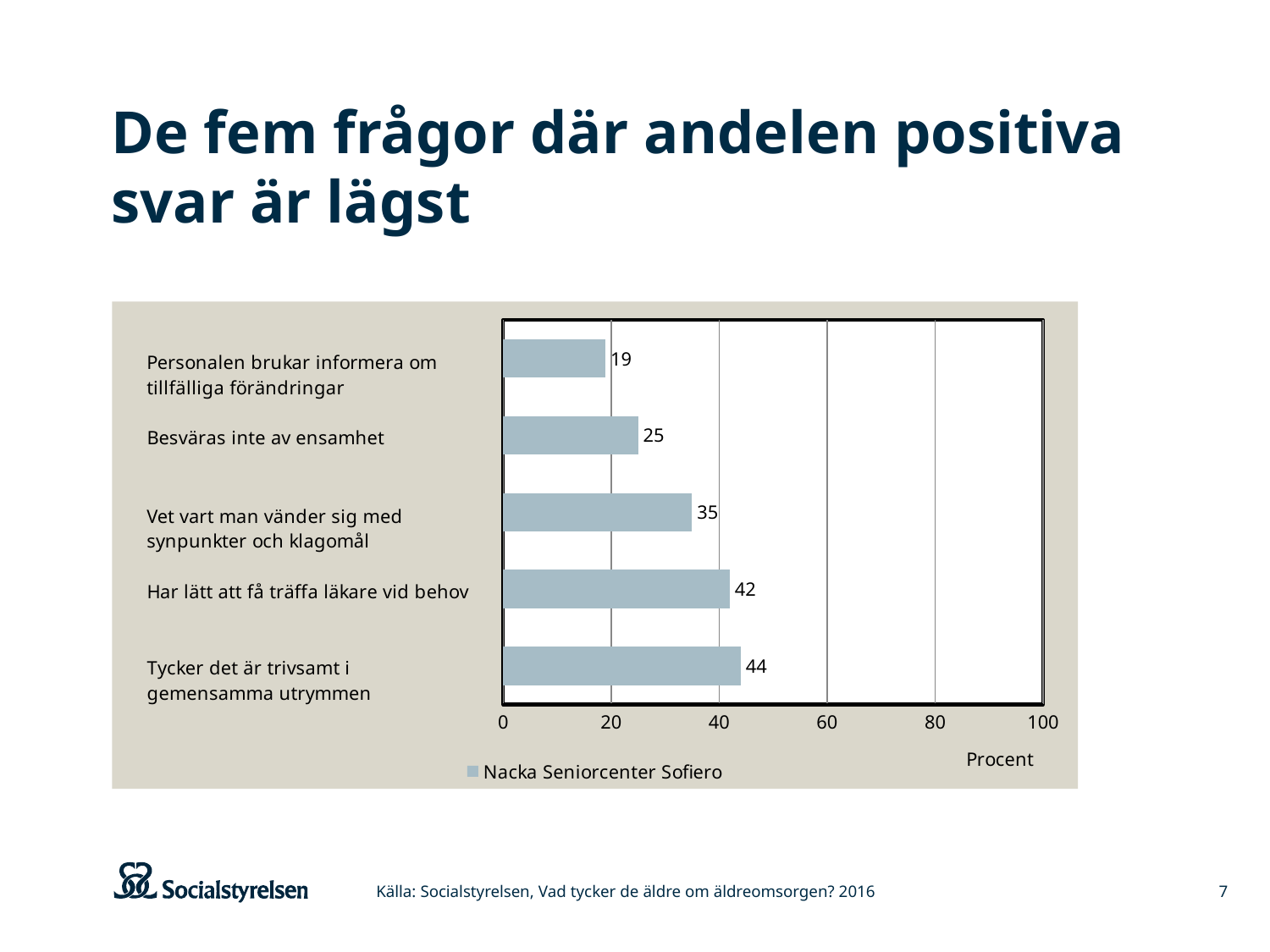
What is the value for "Besväras inte av ensamhet"? 25 Which category has the lowest value? Personalen brukar informera om tillfälliga förändringar What is the value for "Har lätt att få träffa läkare vid behov"? 42 How many categories are shown in the chart? 5 How many series does the legend list? 1 Is the value for "Har lätt att få träffa läkare vid behov" greater or less than 40? greater Which category has the highest value? Tycker det är trivsamt i gemensamma utrymmen What is the value for "Personalen brukar informera om tillfälliga förändringar"? 19 What is the difference between the values for "Tycker det är trivsamt i gemensamma utrymmen" and "Vet vart man vänder sig med synpunkter och klagomål"? 9 What series name is shown in the legend? Nacka Seniorcenter Sofiero Which is larger: the value for "Besväras inte av ensamhet" or the value for "Vet vart man vänder sig med synpunkter och klagomål"? Vet vart man vänder sig med synpunkter och klagomål What kind of chart is shown on the slide? bar chart